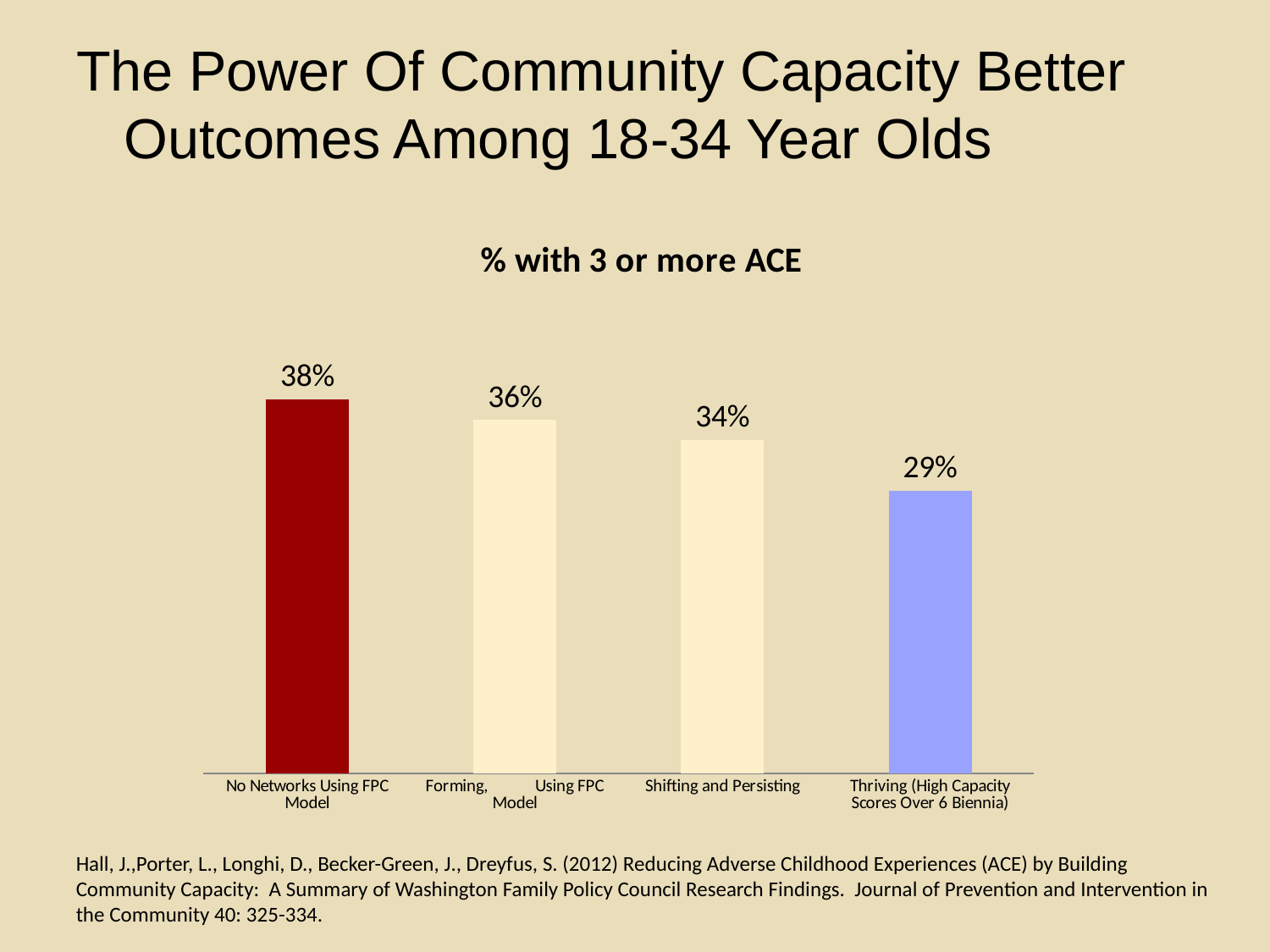
What kind of chart is shown on the slide? Bar chart How many categories are shown in the chart? 4 Which category has the highest value? No Networks Using FPC Model Do the values rise or fall from left to right across the categories? Fall Which category has the lowest value? Thriving (High Capacity Scores Over 6 Biennia) What is the value for No Networks Using FPC Model? 38% Which is larger, the value for Forming, Using FPC Model or the value for Shifting and Persisting? Forming, Using FPC Model What is the value for Shifting and Persisting? 34% What is the value for Forming, Using FPC Model? 36% What is the value for Thriving (High Capacity Scores Over 6 Biennia)? 29% What is the difference between the values for No Networks Using FPC Model and Thriving (High Capacity Scores Over 6 Biennia)? 9% What is the title of the chart? % with 3 or more ACE